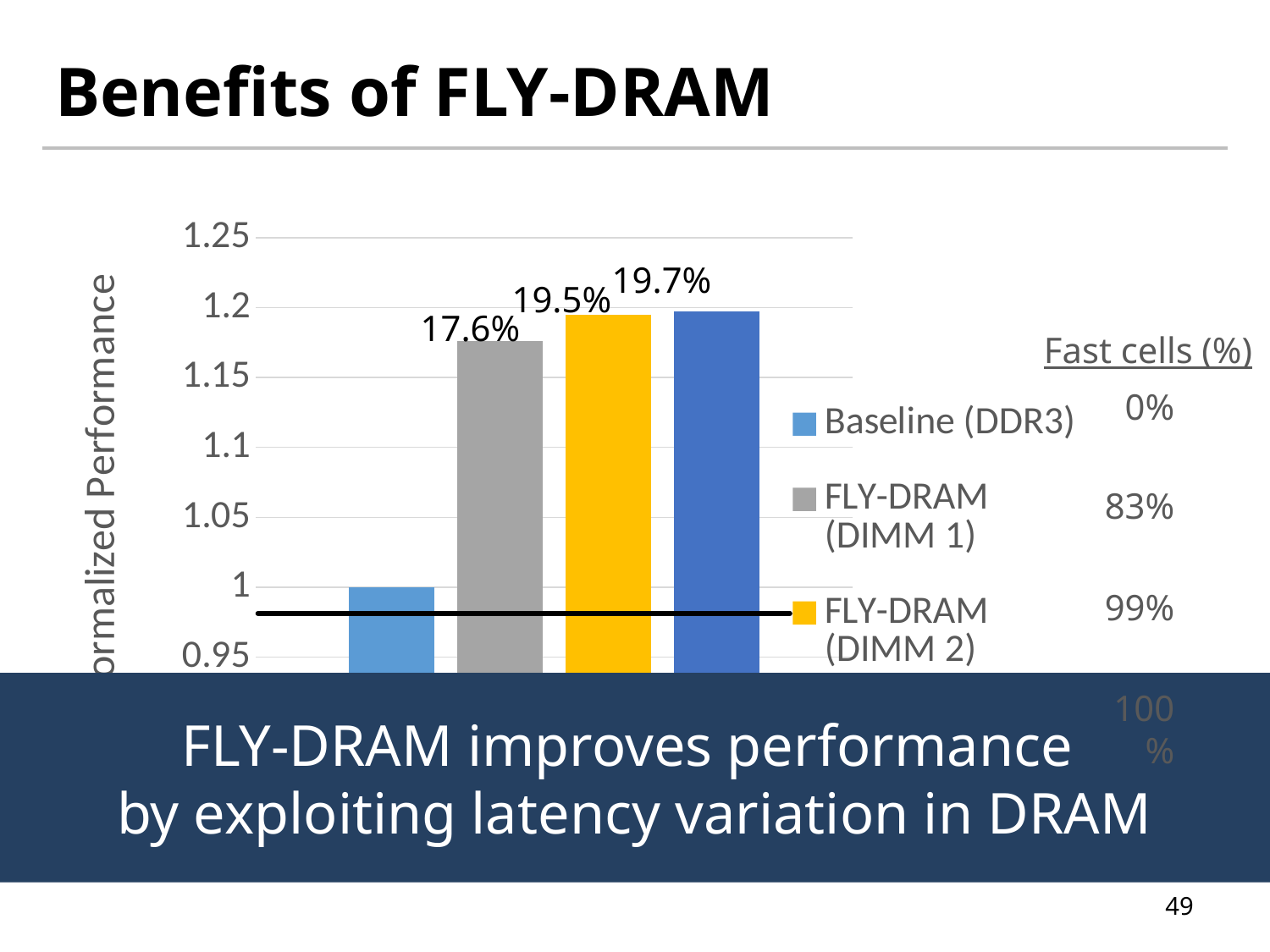
What colour is the Baseline (DDR3) bar in the chart? blue What percentage label is printed above the FLY-DRAM (DIMM 2) bar? 19.5% Which is larger, the FLY-DRAM (DIMM 1) bar or the Baseline (DDR3) bar? FLY-DRAM (DIMM 1) What is the normalized performance value of the Baseline (DDR3) bar? 1 Which is larger, the FLY-DRAM (DIMM 2) bar or the FLY-DRAM (DIMM 1) bar? FLY-DRAM (DIMM 2) What is the difference between the percentage labels of FLY-DRAM (DIMM 2) and FLY-DRAM (DIMM 1)? 1.9% What type of chart is shown on the slide? bar chart How many bars are plotted in the chart? 4 Is the normalized performance of FLY-DRAM (DIMM 1) greater or less than 1.15? greater What percentage label is printed above the FLY-DRAM (DIMM 1) bar? 17.6% Which bar in the chart is the lowest? Baseline (DDR3)